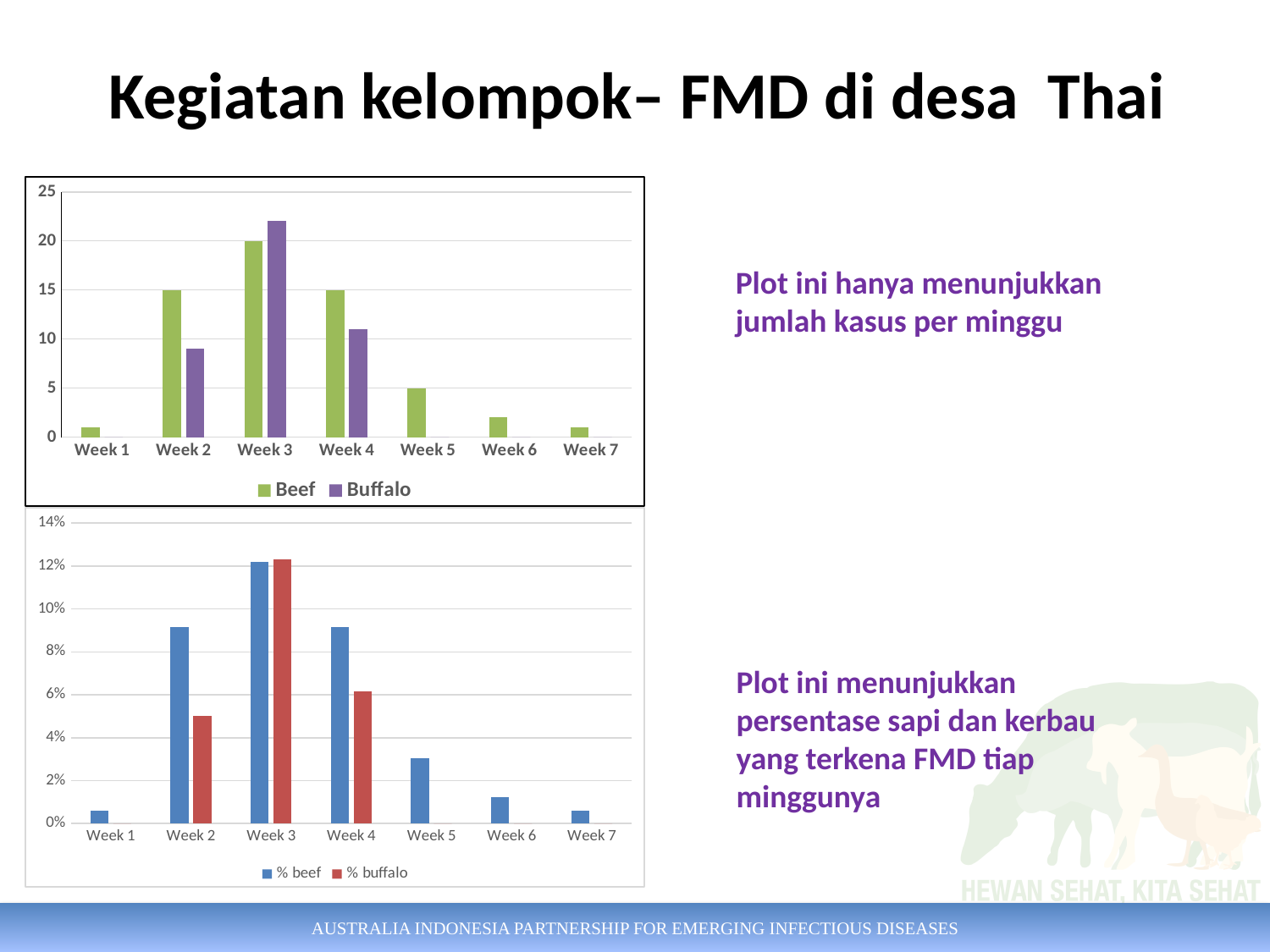
In the top chart, which is larger for Week 3, Beef or Buffalo? Buffalo In the top chart, what is the Beef value for Week 5? 5 In the bottom chart, which is larger for Week 4, % beef or % buffalo? % beef In the top chart, how many weeks are shown on the x axis? 7 In the top chart, how many series does the legend list? 2 In the top chart, is the Buffalo value for Week 3 greater or less than 20? greater In the bottom chart, is the % beef value for Week 2 greater or less than 8%? greater What kind of chart is the top chart on the slide? bar chart In the top chart, which week has the highest Beef value? Week 3 In the bottom chart, what are the two legend entries? % beef and % buffalo In the bottom chart, which week has the highest % buffalo value? Week 3 In the top chart, what is the Beef value for Week 3? 20